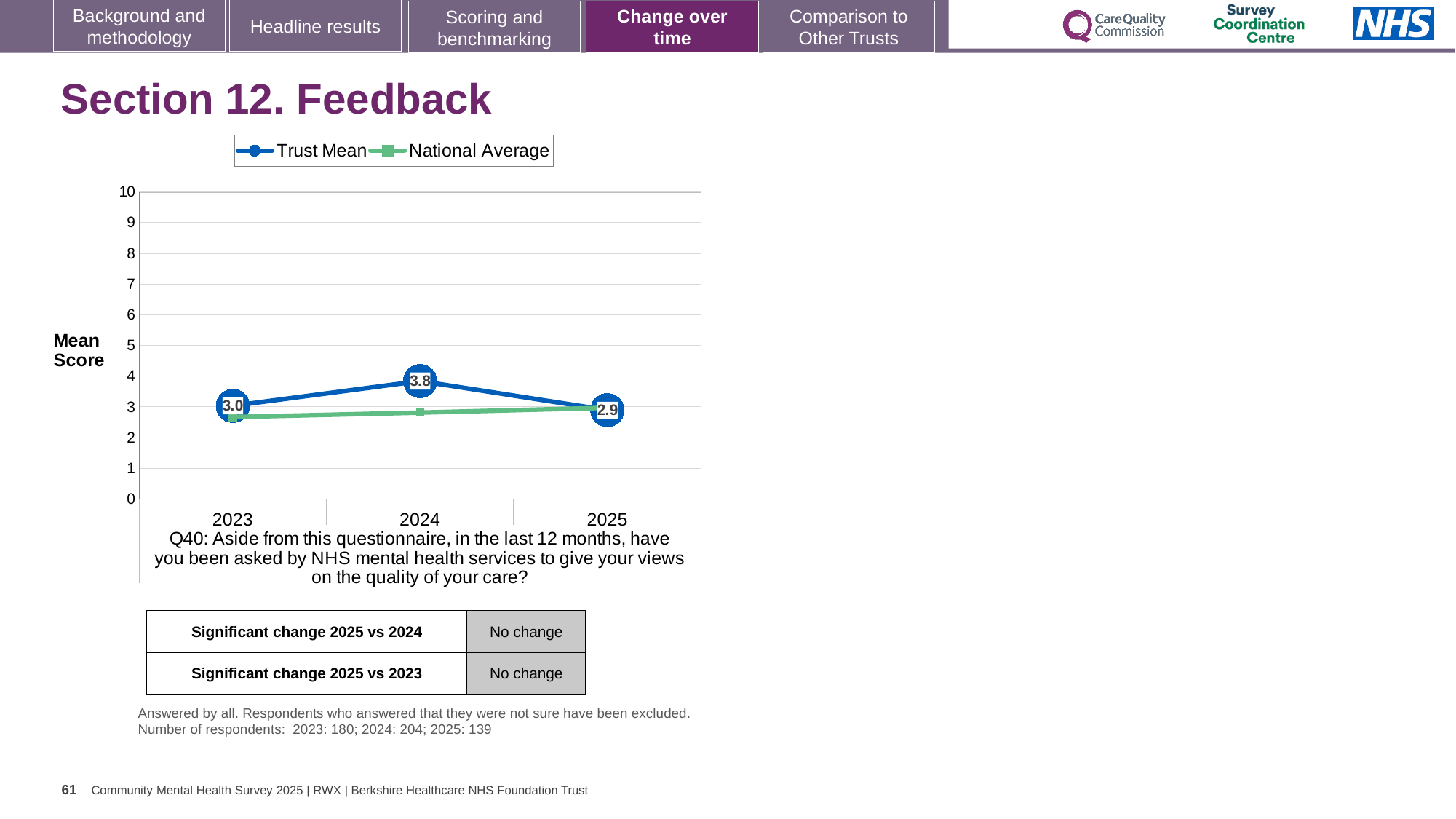
Does the Trust Mean rise or fall from 2024 to 2025? fall What kind of chart is shown? line chart What is the Trust Mean score for 2023? 3.0 What is the difference between the Trust Mean in 2024 and in 2025? 0.9 In which year is the Trust Mean highest? 2024 In which year is the Trust Mean lowest? 2025 Which is larger, the Trust Mean in 2023 or in 2024? 2024 How many series does the legend list? 2 What is the Trust Mean score for 2024? 3.8 What is the Trust Mean score for 2025? 2.9 Is the National Average for 2023 greater or less than 4? less How many years are shown on the x axis? 3